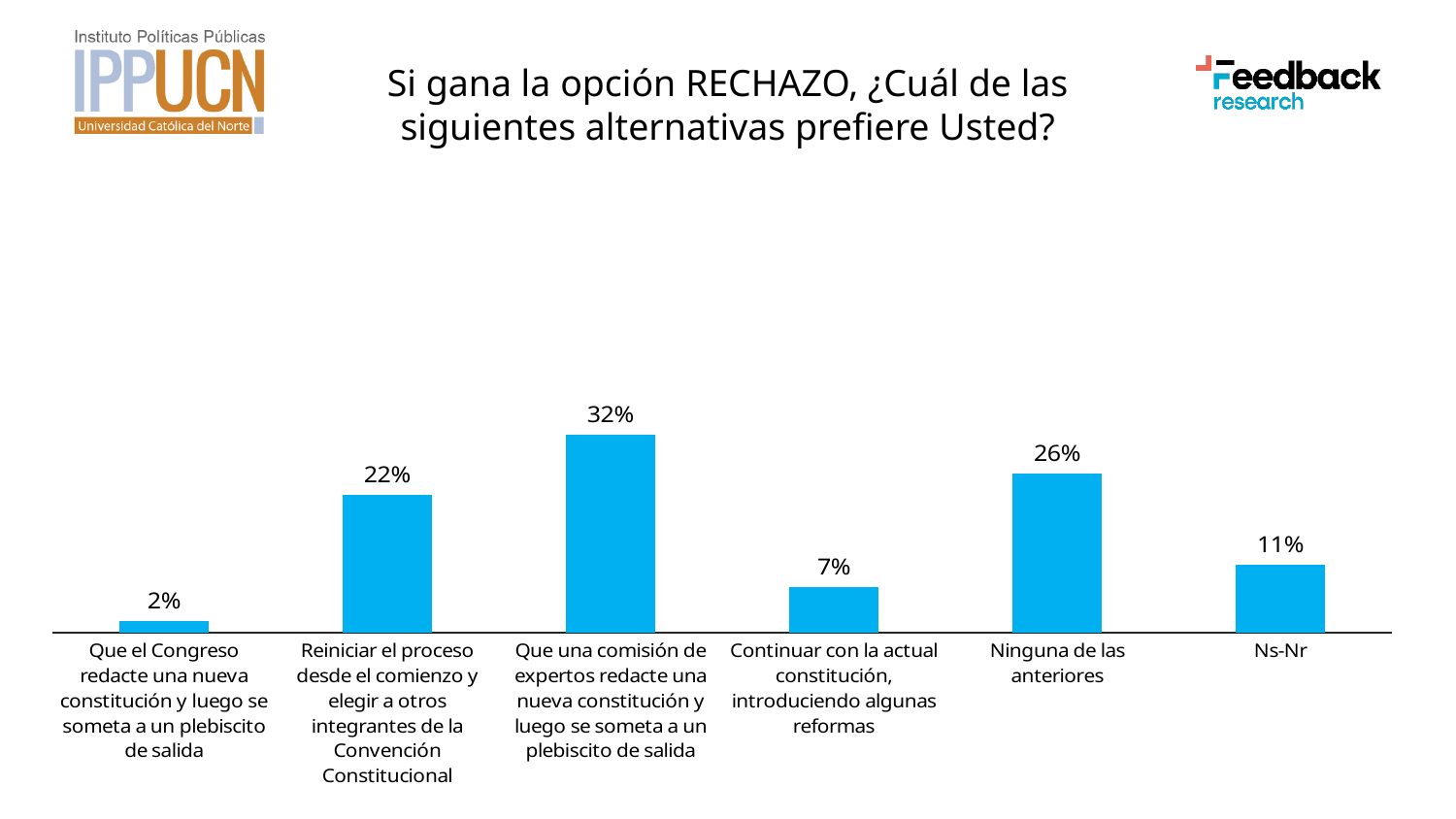
How many categories are shown in the chart? 6 What is the difference between the value for the expert commission option and the value for restarting the process with a new Convention? 10% What is the value for 'Ninguna de las anteriores'? 26% What is the value for 'Ns-Nr'? 11% Which is larger: the value for 'Ninguna de las anteriores' or the value for 'Reiniciar el proceso desde el comienzo y elegir a otros integrantes de la Convención Constitucional'? Ninguna de las anteriores What percentage of respondents prefer that a commission of experts draft a new constitution and then submit it to an exit plebiscite? 32% Which alternative has the lowest percentage? Que el Congreso redacte una nueva constitución y luego se someta a un plebiscito de salida Which alternative has the highest percentage? Que una comisión de expertos redacte una nueva constitución y luego se someta a un plebiscito de salida What percentage prefer continuing with the current constitution while introducing some reforms? 7% What question is the chart answering, according to the slide title? Si gana la opción RECHAZO, ¿Cuál de las siguientes alternativas prefiere Usted? What is the difference between the value for 'Ns-Nr' and the value for 'Continuar con la actual constitución, introduciendo algunas reformas'? 4% What kind of chart is shown on the slide? Bar chart